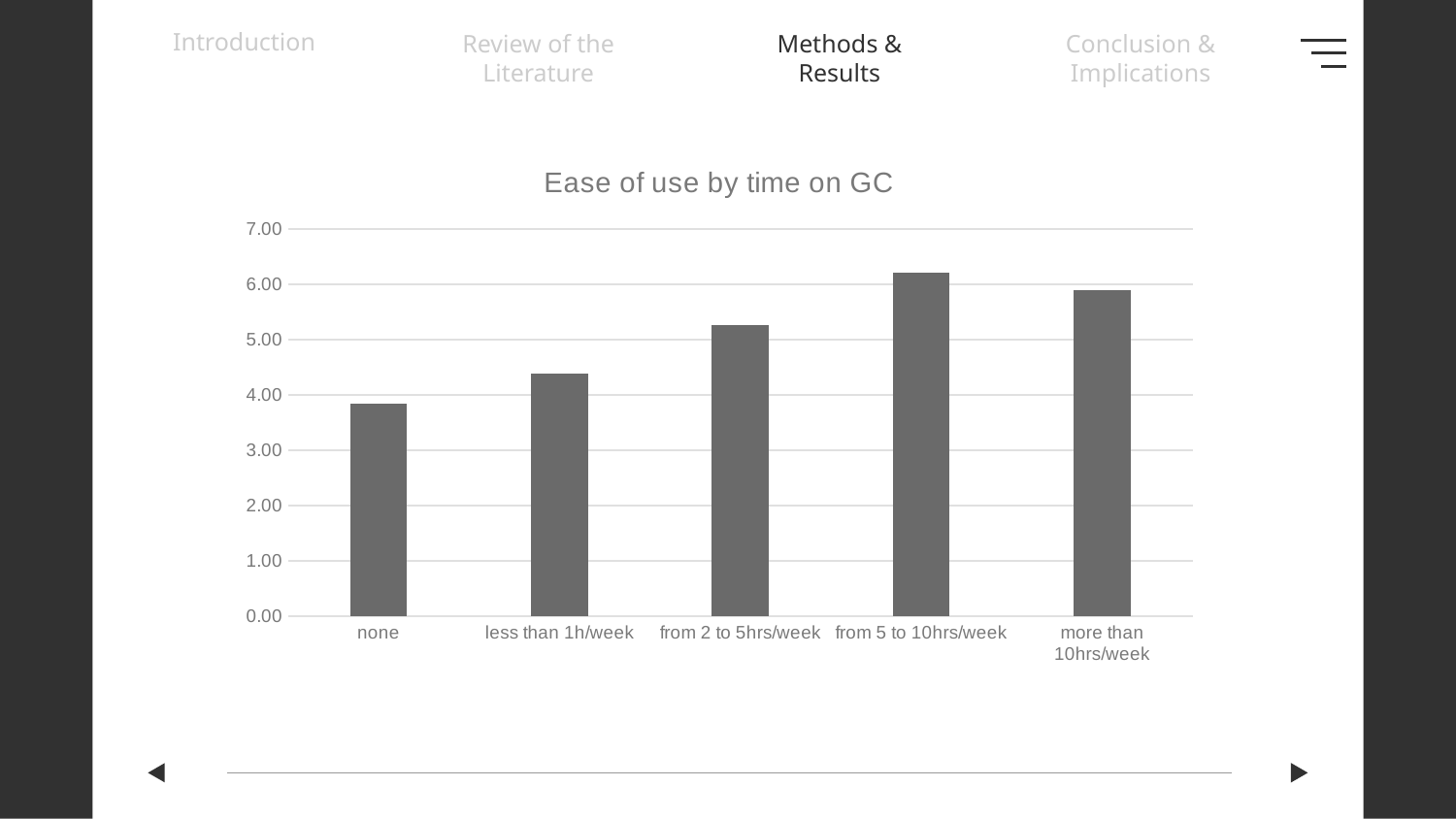
Is the value for 'from 2 to 5hrs/week' greater or less than 5.00? greater Which category has the lowest bar in the chart? none Is the value for 'from 5 to 10hrs/week' greater or less than 6.00? greater Is the value for 'more than 10hrs/week' greater or less than 5.00? greater Which category has the highest bar in the chart? from 5 to 10hrs/week Which is larger, the value for 'none' or the value for 'less than 1h/week'? less than 1h/week Which is larger, the value for 'from 2 to 5hrs/week' or the value for 'from 5 to 10hrs/week'? from 5 to 10hrs/week What kind of chart is shown on the slide? bar chart How many categories are shown on the x axis of the chart? 5 What is the title of the chart? Ease of use by time on GC